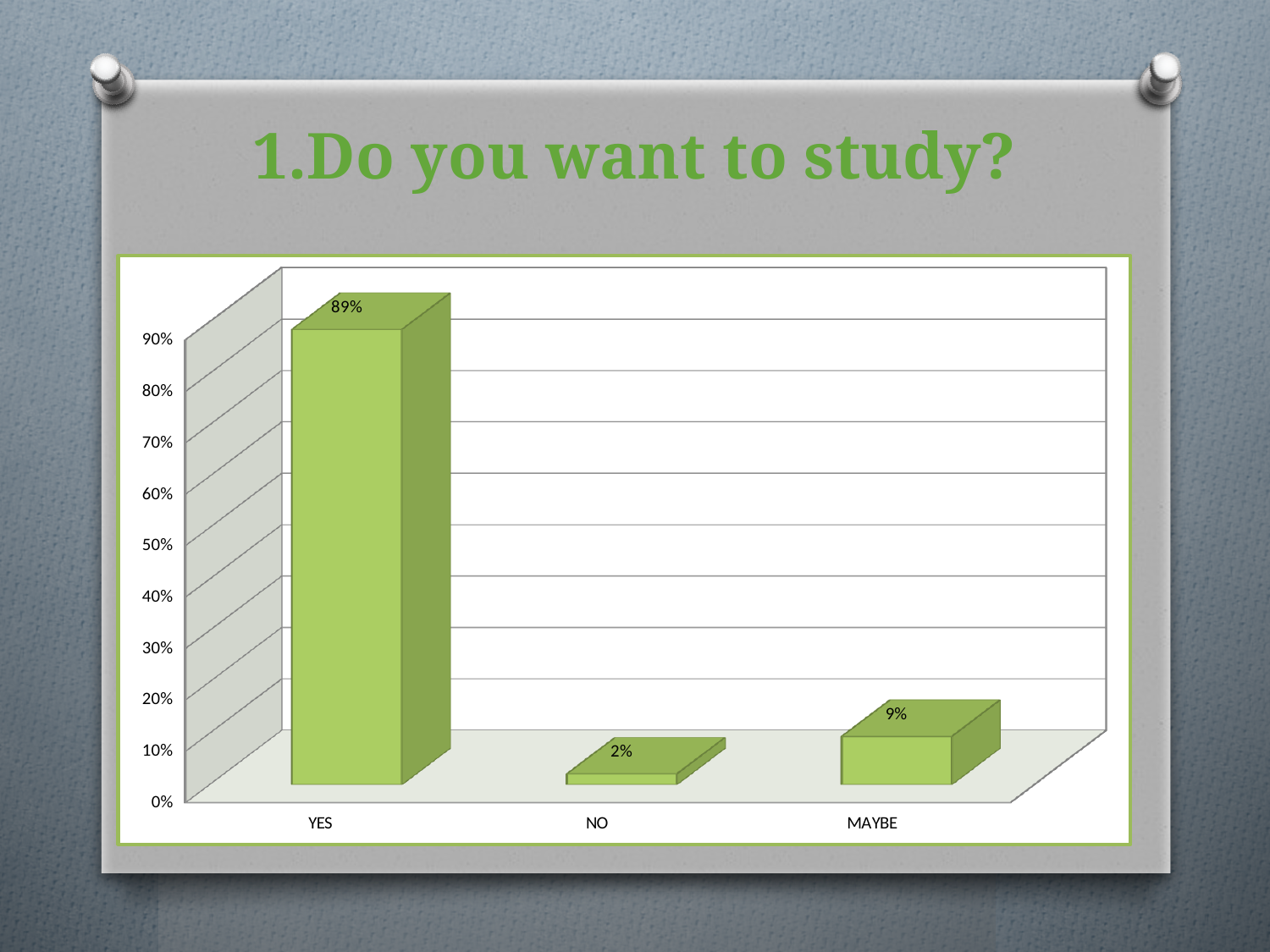
Which category has the lowest value? NO How many categories are shown on the x axis? 3 What is the difference between the values for YES and MAYBE? 80% What is the value for YES? 89% What is the difference between the values for MAYBE and NO? 7% What is the value for MAYBE? 9% Which category has the highest value? YES What kind of chart is shown on the slide? bar chart Is the value for YES greater or less than 80%? greater What is the title of the slide above the chart? 1.Do you want to study? Which is larger, the value for NO or the value for MAYBE? MAYBE What is the value for NO? 2%